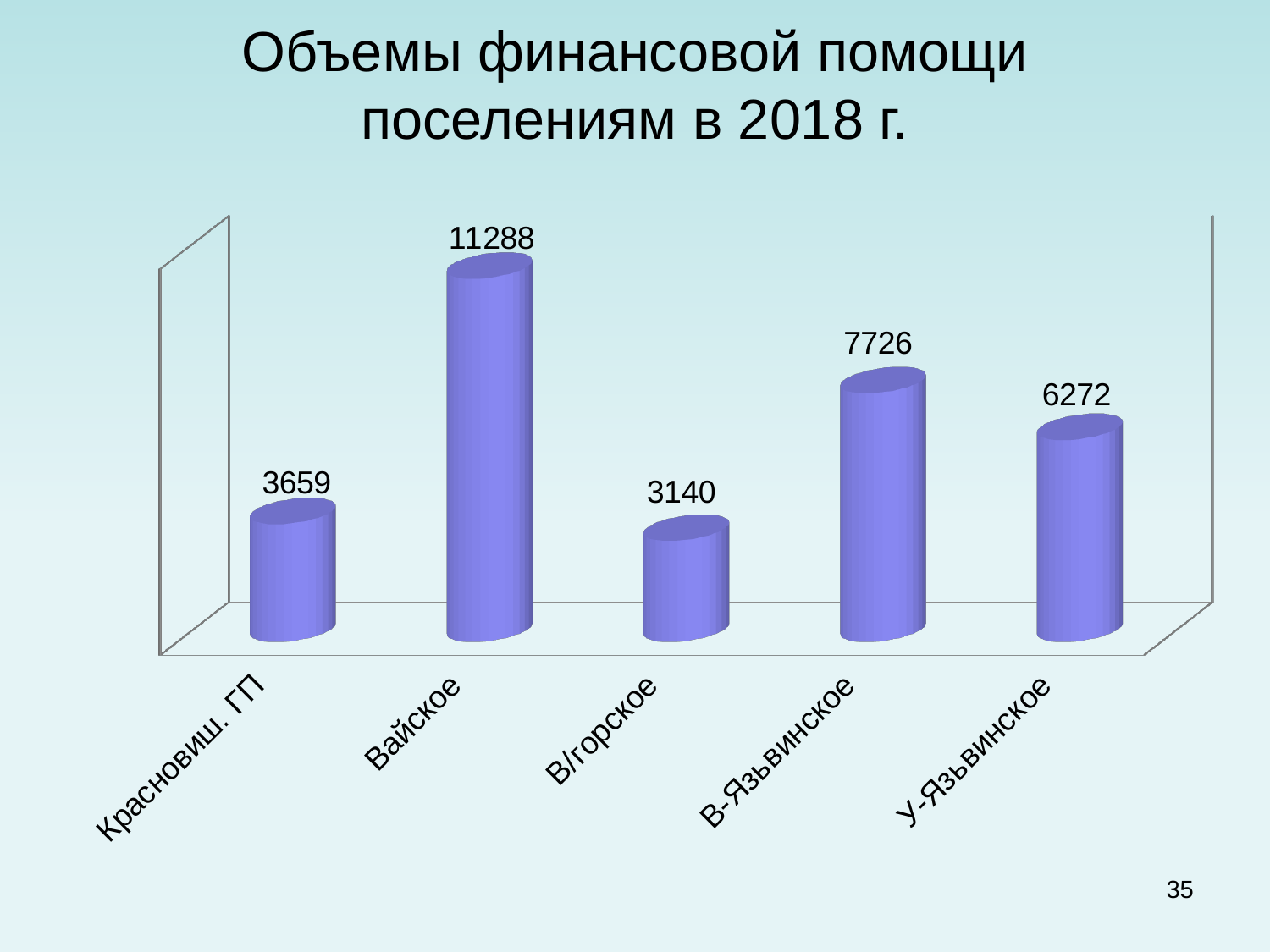
What is the difference between the values for Вайское and В-Язьвинское? 3562 How many categories are shown in the chart? 5 What kind of chart is shown on the slide? bar chart What is the title of the chart? Объемы финансовой помощи поселениям в 2018 г. What is the value for У-Язьвинское? 6272 What is the value for Красновиш. ГП? 3659 What is the value for Вайское? 11288 What is the value for В/горское? 3140 Which category has the lowest value? В/горское What is the value for В-Язьвинское? 7726 Which is larger, the value for В-Язьвинское or the value for У-Язьвинское? В-Язьвинское Which category has the highest value? Вайское